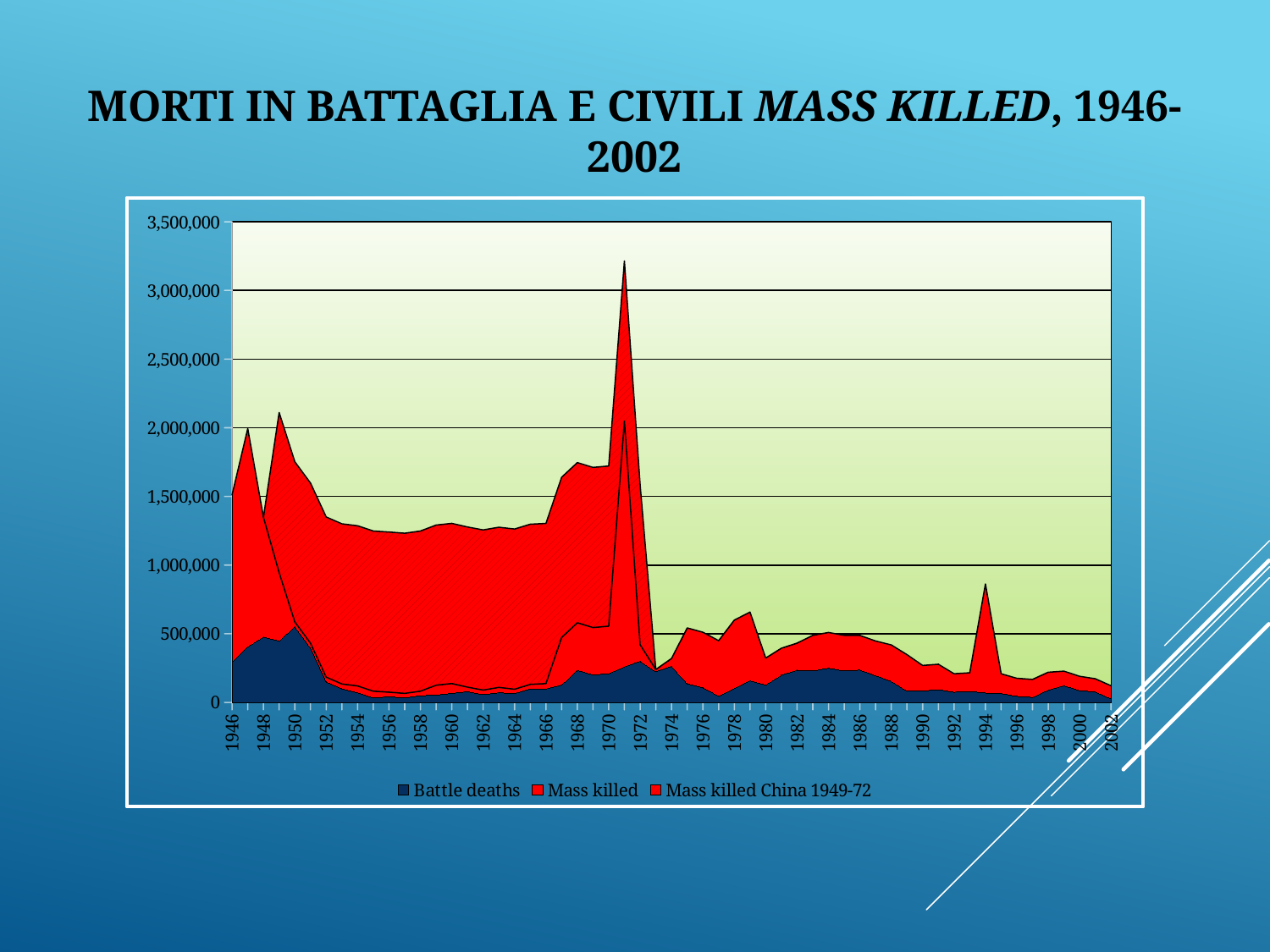
How many series does the legend list? 3 Is the stacked total in 1994 greater or less than 500,000? greater Which year has the larger value for Battle deaths, 1950 or 1996? 1950 Does the stacked total rise or fall from 1994 to 2002? fall Which year has the larger stacked total, 1949 or 1971? 1971 Is the stacked total in 1960 greater or less than 1,500,000? less What are the three series named in the legend? Battle deaths, Mass killed, Mass killed China 1949-72 Is the stacked total in 1971 greater or less than 3,000,000? greater What is the title of the chart on the slide? Morti in battaglia e civili mass killed, 1946-2002 In which year does the stacked total reach its highest peak? 1971 What kind of chart is shown on the slide? Area chart